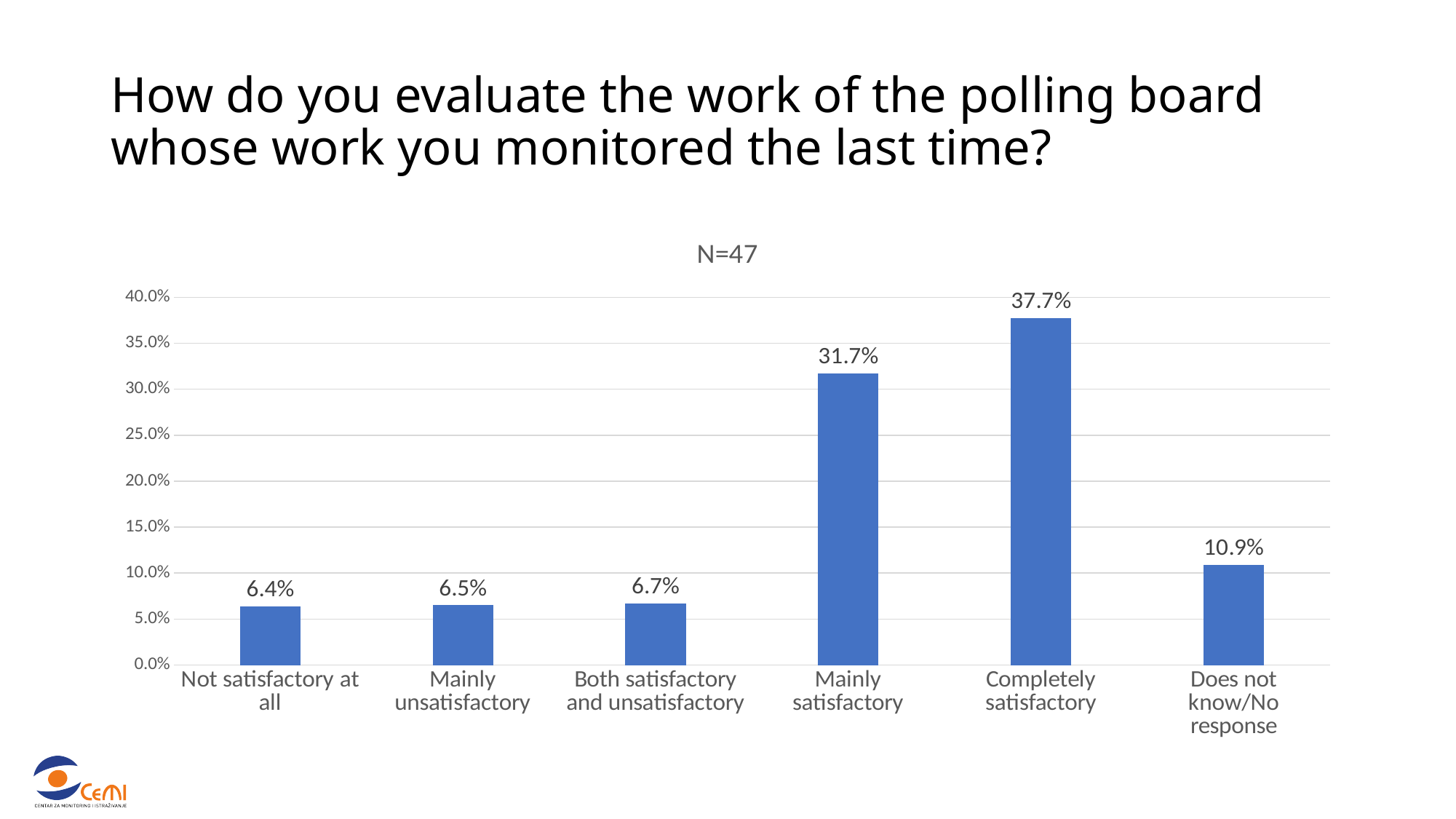
How many categories are shown on the x axis? 6 What is the value for "Mainly satisfactory"? 31.7% Which category has the highest value? Completely satisfactory What kind of chart is shown on the slide? bar chart What is the chart's title? N=47 Is the value for "Both satisfactory and unsatisfactory" greater or less than 10.0%? less What is the value for "Does not know/No response"? 10.9% What is the value for "Completely satisfactory"? 37.7% What is the difference between "Completely satisfactory" and "Mainly satisfactory"? 6.0% Which category has the lowest value? Not satisfactory at all Which is larger, "Mainly satisfactory" or "Does not know/No response"? Mainly satisfactory What is the value for "Not satisfactory at all"? 6.4%